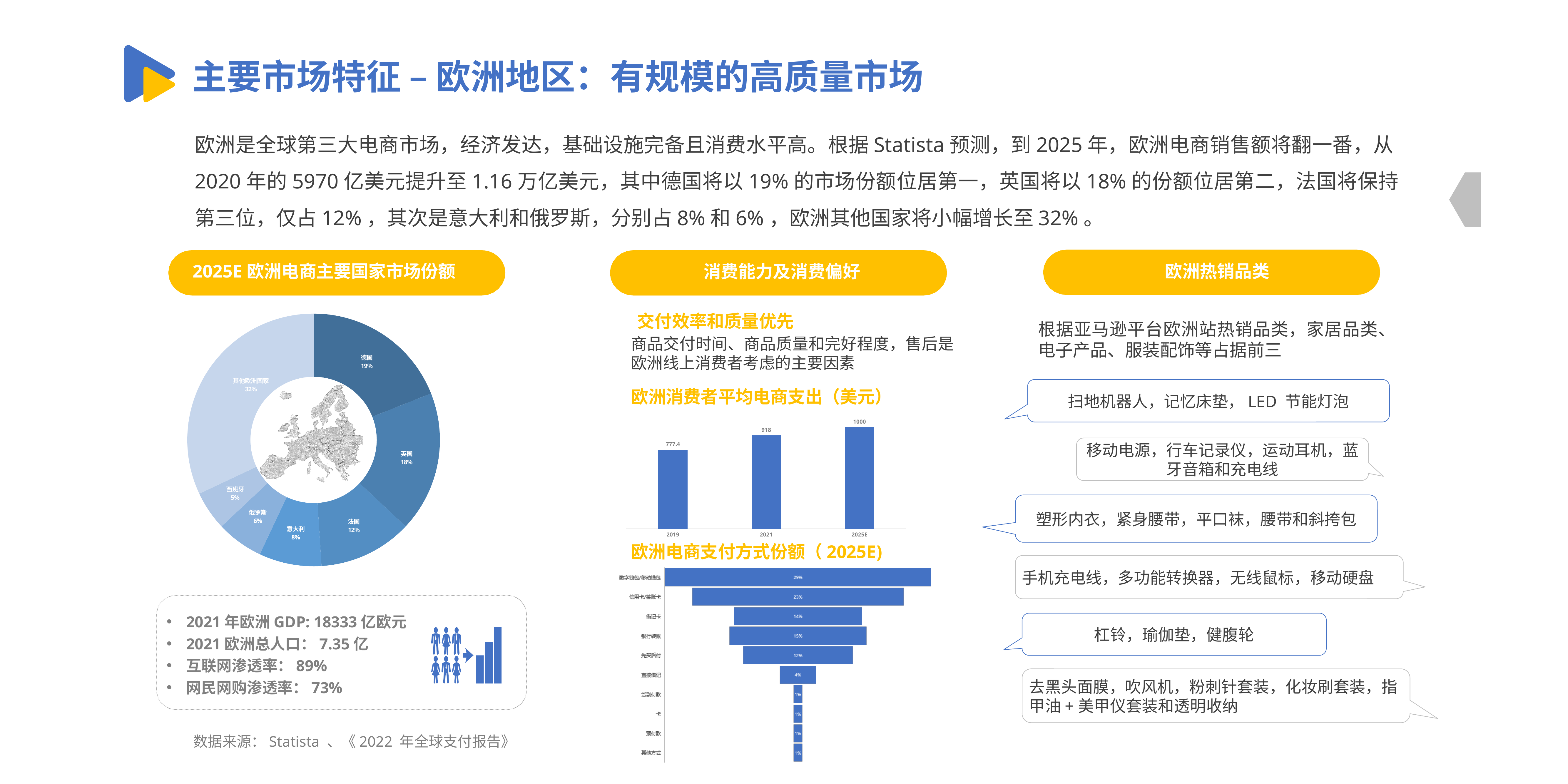
In the chart titled 欧洲消费者平均电商支出（美元）, what is the difference between the 2025E and 2021 values? 82 In the chart titled 欧洲电商支付方式份额（2025E）, which payment method has the largest share? 数字钱包/移动钱包 In the chart titled 欧洲电商支付方式份额（2025E）, which is larger, 借记卡 or 银行转账? 银行转账 In the chart titled 2025E 欧洲电商主要国家市场份额, what share is shown for 德国? 19% In the chart titled 欧洲消费者平均电商支出（美元）, which year has the highest value? 2025E In the chart titled 欧洲消费者平均电商支出（美元）, what is the value for 2019? 777.4 What kind of chart is the one titled 2025E 欧洲电商主要国家市场份额? Pie (donut) chart In the chart titled 2025E 欧洲电商主要国家市场份额, what is the difference between the shares of 英国 and 法国? 6% In the chart titled 2025E 欧洲电商主要国家市场份额, which named country has the smallest share? 西班牙 In the chart titled 欧洲电商支付方式份额（2025E）, what share is shown for 信用卡/签账卡? 23% In the chart titled 欧洲消费者平均电商支出（美元）, do the values rise or fall from 2019 to 2025E? Rise In the chart titled 2025E 欧洲电商主要国家市场份额, how many slices does the chart have? 7